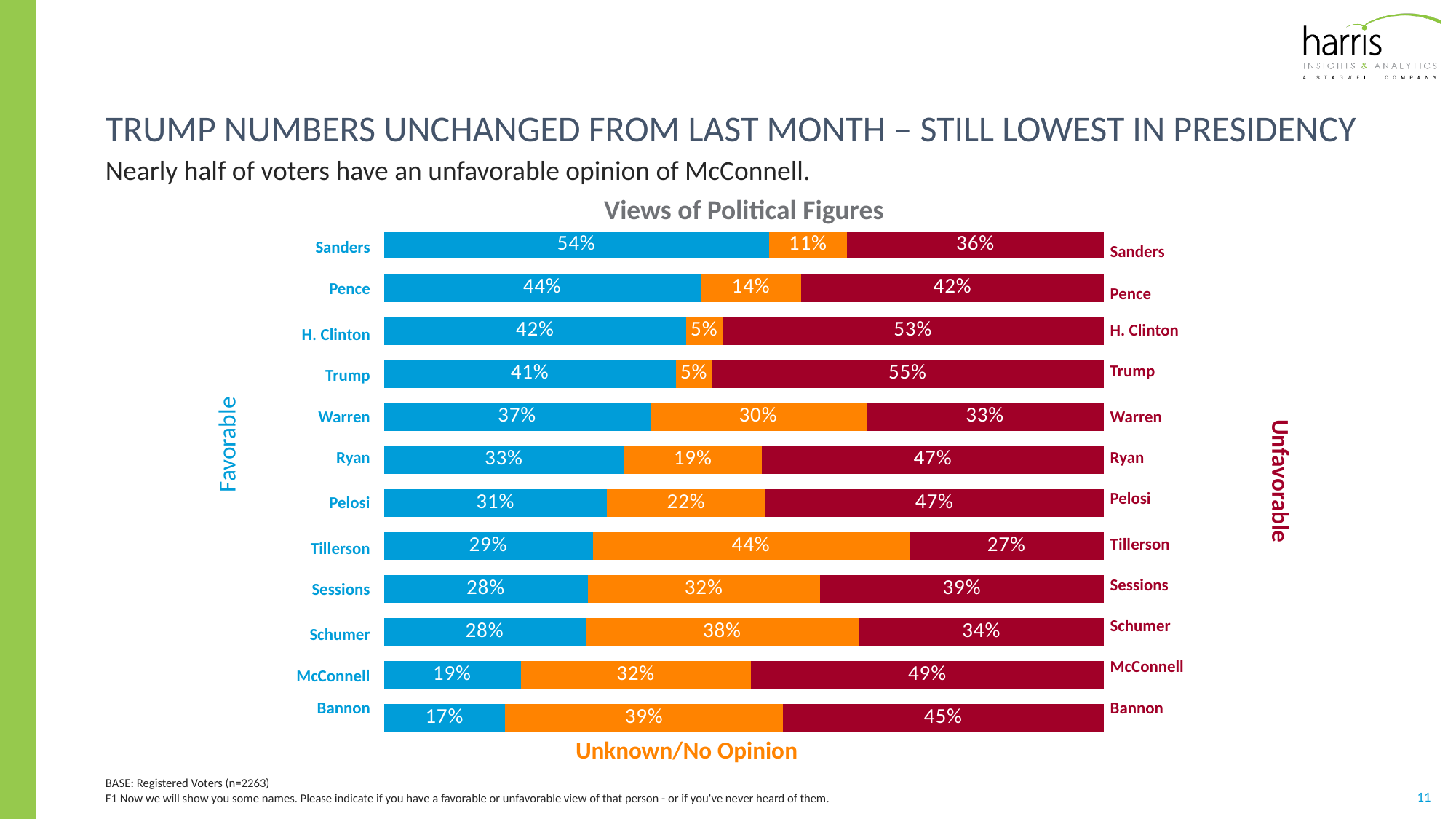
Which political figure has the highest favorable percentage? Sanders How many political figures are shown in the chart? 12 Who has the larger favorable percentage, Pence or H. Clinton? Pence By how many percentage points does Trump's unfavorable share exceed his favorable share? 14 percentage points What is the unfavorable percentage for Trump? 55% Which political figure has the lowest favorable percentage? Bannon What type of chart is used to show the views of political figures? Stacked bar chart How many series (response categories) does the chart show for each figure? 3 Which political figure has the highest unfavorable percentage? Trump What is the unfavorable percentage for McConnell? 49% What is the Unknown/No Opinion percentage for Tillerson? 44% What percentage of voters have a favorable view of Sanders? 54%